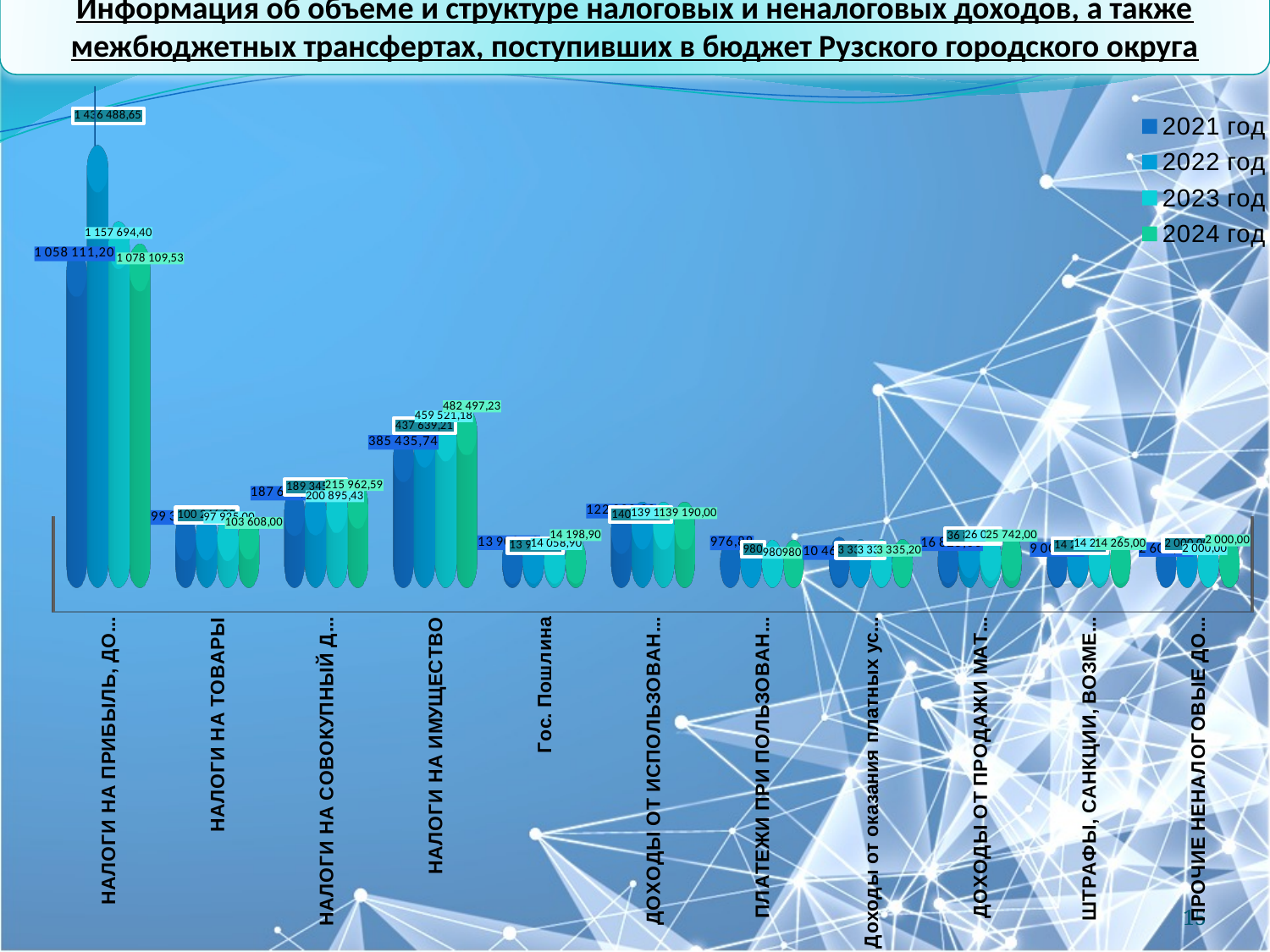
What is the difference between the 2024 год and 2021 год values for НАЛОГИ НА ИМУЩЕСТВО? 97 061,49 What is the value for 2024 год for НАЛОГИ НА ТОВАРЫ? 103 608,00 How many categories are shown along the x axis? 11 Which year has the highest value in the first category (НАЛОГИ НА ПРИБЫЛЬ...)? 2022 год What is the value for 2022 год in the first category (НАЛОГИ НА ПРИБЫЛЬ...)? 1 436 488,65 What is the value for 2024 год for Гос. Пошлина? 14 198,90 Which category has the highest values overall? НАЛОГИ НА ПРИБЫЛЬ... How many series does the legend list? 4 What is the value for 2024 год for НАЛОГИ НА ИМУЩЕСТВО? 482 497,23 What kind of chart is shown on the slide? Bar chart Which years are listed in the legend? 2021 год, 2022 год, 2023 год, 2024 год Do the values for НАЛОГИ НА ИМУЩЕСТВО rise or fall from 2021 год to 2024 год? Rise